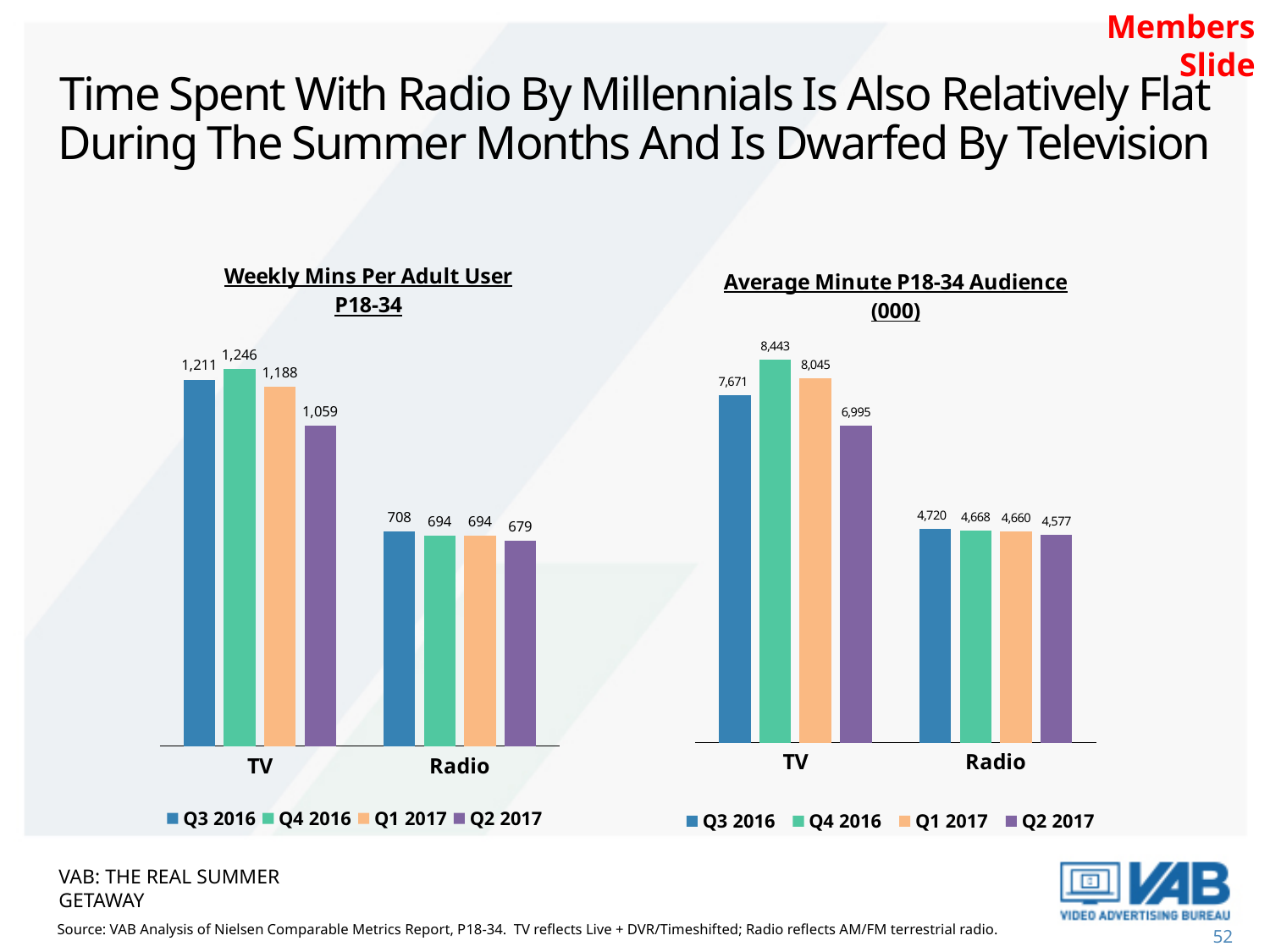
In the 'Average Minute P18-34 Audience (000)' chart, what is the value for TV in Q3 2016? 7,671 In the 'Average Minute P18-34 Audience (000)' chart, what is the difference between the Q4 2016 and Q2 2017 values for TV? 1,448 In the 'Average Minute P18-34 Audience (000)' chart, do the Radio values rise or fall from Q3 2016 to Q2 2017? Fall In the 'Weekly Mins Per Adult User P18-34' chart, which is larger for TV: Q1 2017 or Q2 2017? Q1 2017 What kind of chart is the 'Weekly Mins Per Adult User P18-34' chart? Bar chart In the 'Weekly Mins Per Adult User P18-34' chart, what is the value for TV in Q4 2016? 1,246 In the 'Weekly Mins Per Adult User P18-34' chart, what is the value for Radio in Q2 2017? 679 How many series does the legend of the 'Average Minute P18-34 Audience (000)' chart list? 4 In the 'Weekly Mins Per Adult User P18-34' chart, which quarter has the highest value for TV? Q4 2016 In the 'Average Minute P18-34 Audience (000)' chart, which quarter has the lowest value for TV? Q2 2017 In the 'Weekly Mins Per Adult User P18-34' chart, what is the difference between the TV and Radio values for Q3 2016? 503 In the 'Average Minute P18-34 Audience (000)' chart, what is the value for Radio in Q1 2017? 4,660